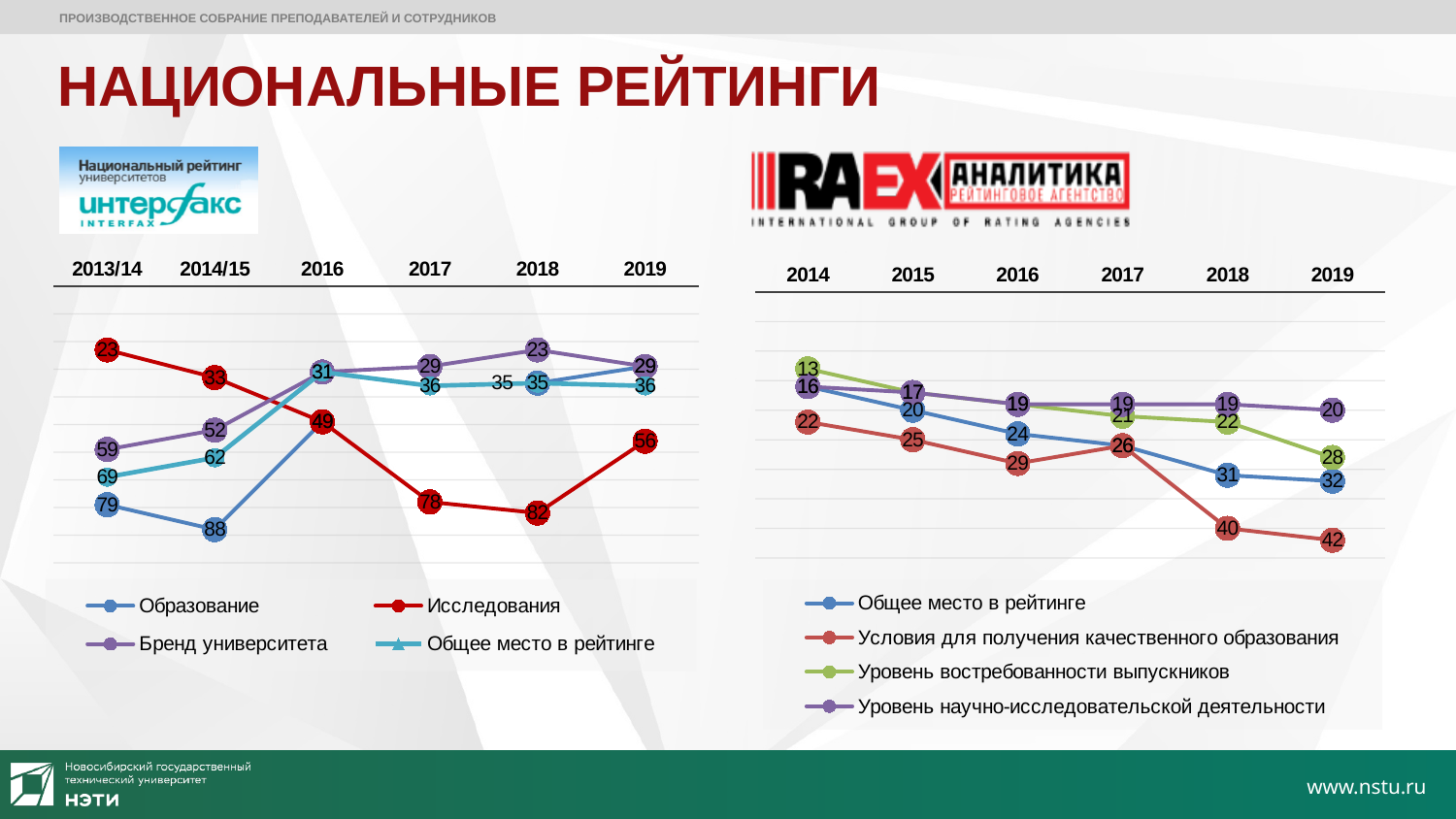
How many periods are shown on the x axis of the left chart (Интерфакс)? 6 In the left chart (Интерфакс), what is the difference between the Исследования values for 2018 and 2013/14? 59 In the left chart (Интерфакс), what is the value for Образование in 2014/15? 88 In the right chart (RAEX), what is the value for Общее место в рейтинге in 2014? 16 In the left chart (Интерфакс), what is the value for Общее место в рейтинге in 2013/14? 69 In the left chart (Интерфакс), which series has the highest value in 2014/15? Образование What kind of chart is the left chart (Интерфакс national rating)? line chart How many series does the legend of the left chart (Интерфакс) list? 4 In the left chart (Интерфакс), what is the value for Исследования in 2018? 82 In the right chart (RAEX), what is the value for Условия для получения качественного образования in 2019? 42 In the right chart (RAEX), what is the difference between the 2019 and 2018 values for Условия для получения качественного образования? 2 In the right chart (RAEX), do the values for Общее место в рейтинге rise or fall from 2014 to 2019? rise